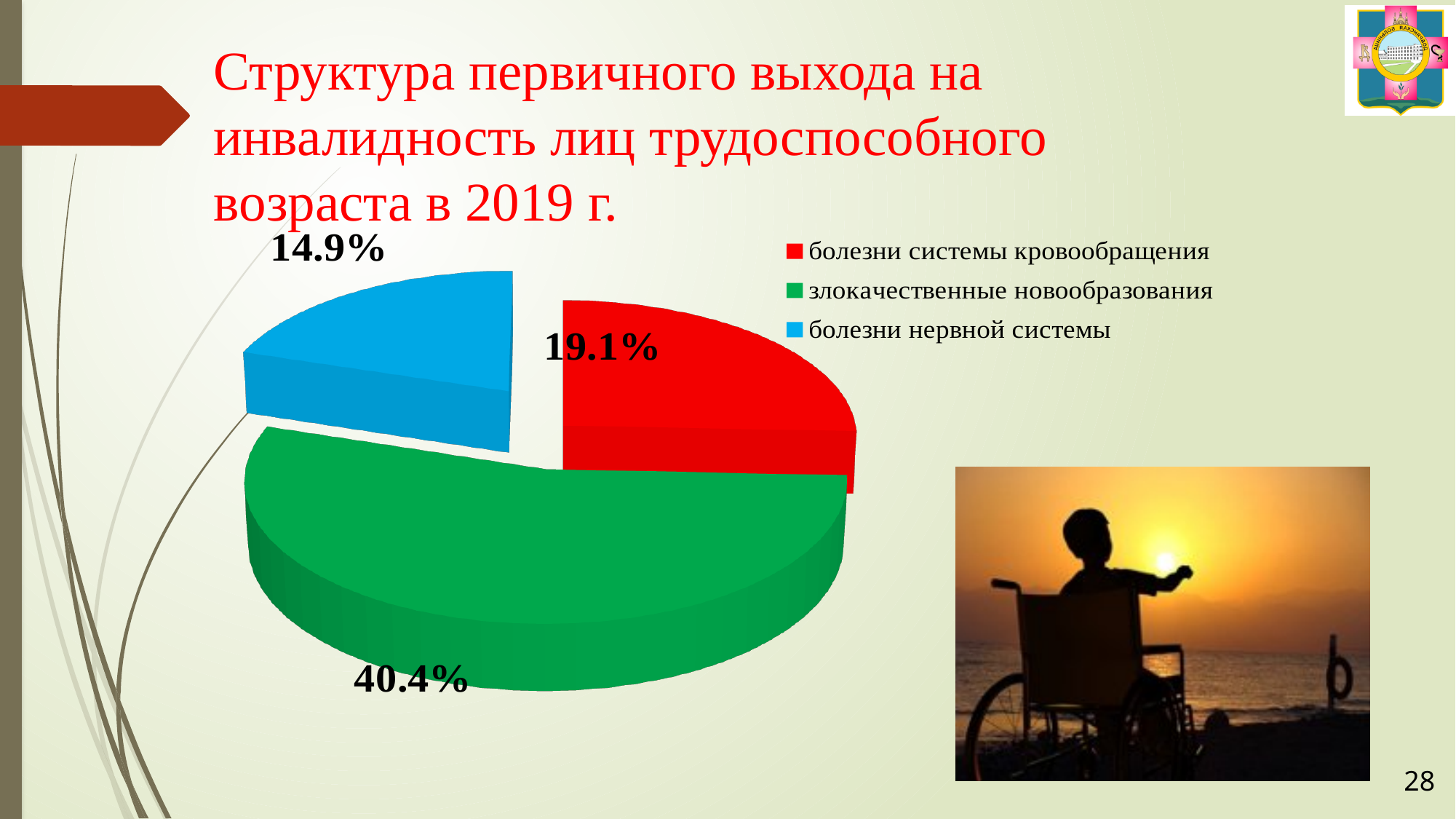
What is the value shown for болезни системы кровообращения? 19.1% What is the difference between the values for болезни системы кровообращения and болезни нервной системы? 4.2% What is the value shown for болезни нервной системы? 14.9% Which is larger: the value for болезни системы кровообращения or the value for болезни нервной системы? болезни системы кровообращения How many entries does the legend list? 3 Which category has the smallest slice of the pie? болезни нервной системы What is the difference between the values for злокачественные новообразования and болезни системы кровообращения? 21.3% Which category has the largest slice of the pie? злокачественные новообразования What colour is the slice for болезни нервной системы? blue What kind of chart is shown on the slide? pie chart How many categories does the pie chart show? 3 What is the value shown for злокачественные новообразования? 40.4%